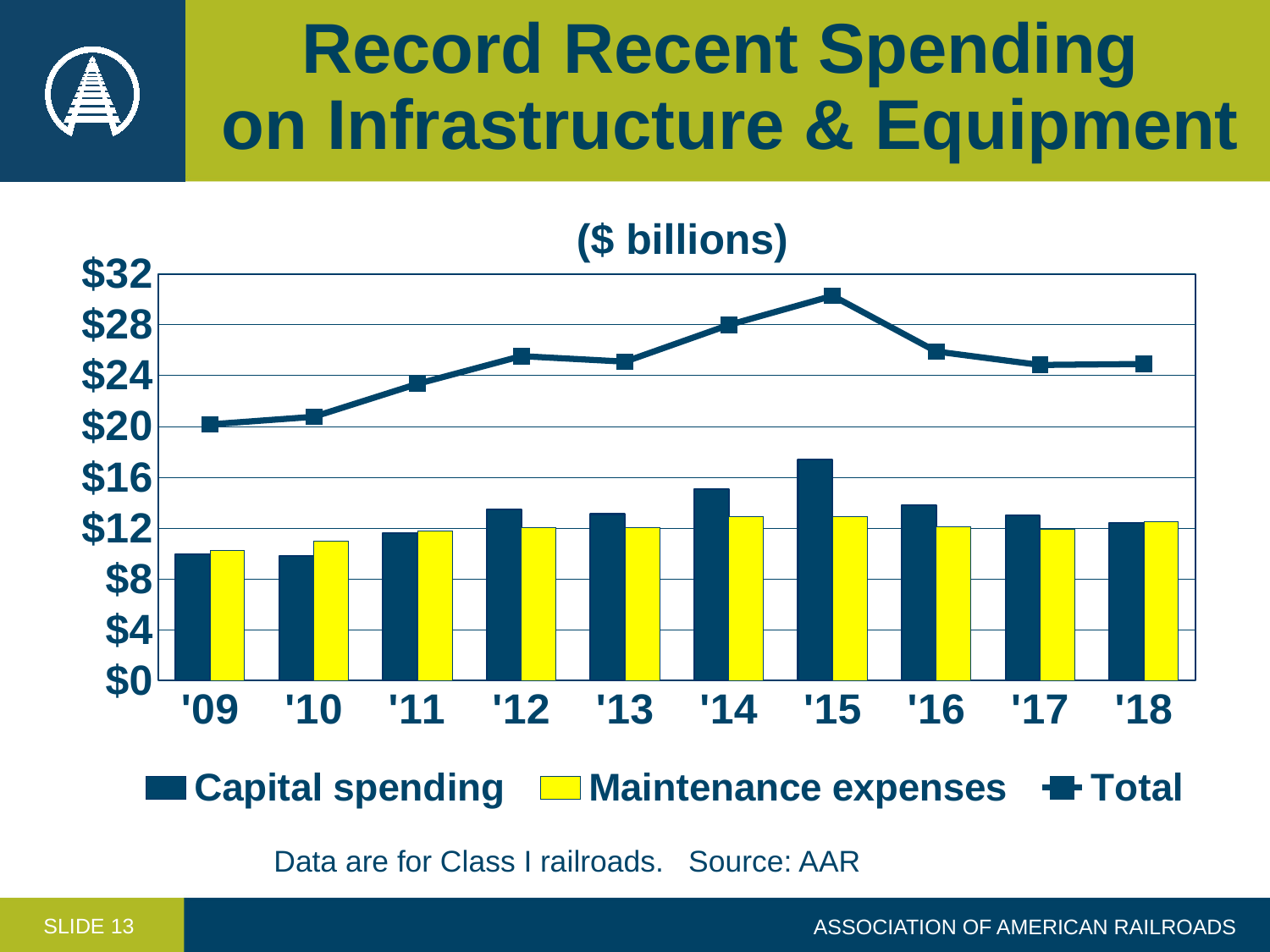
How many years are shown on the x axis? 10 How many series does the legend list? 3 Is Maintenance expenses for '09 greater or less than $12? less Is Capital spending for '15 greater or less than $16? greater What kind of chart is shown on the slide? A combined bar and line chart In which year is the Total highest? '15 Is the Total for '09 greater or less than $24? less Does the Total rise or fall from '09 to '15? Rise In '15, which is larger: Capital spending or Maintenance expenses? Capital spending Is the Total larger in '14 or in '16? '14 In which year is Capital spending highest? '15